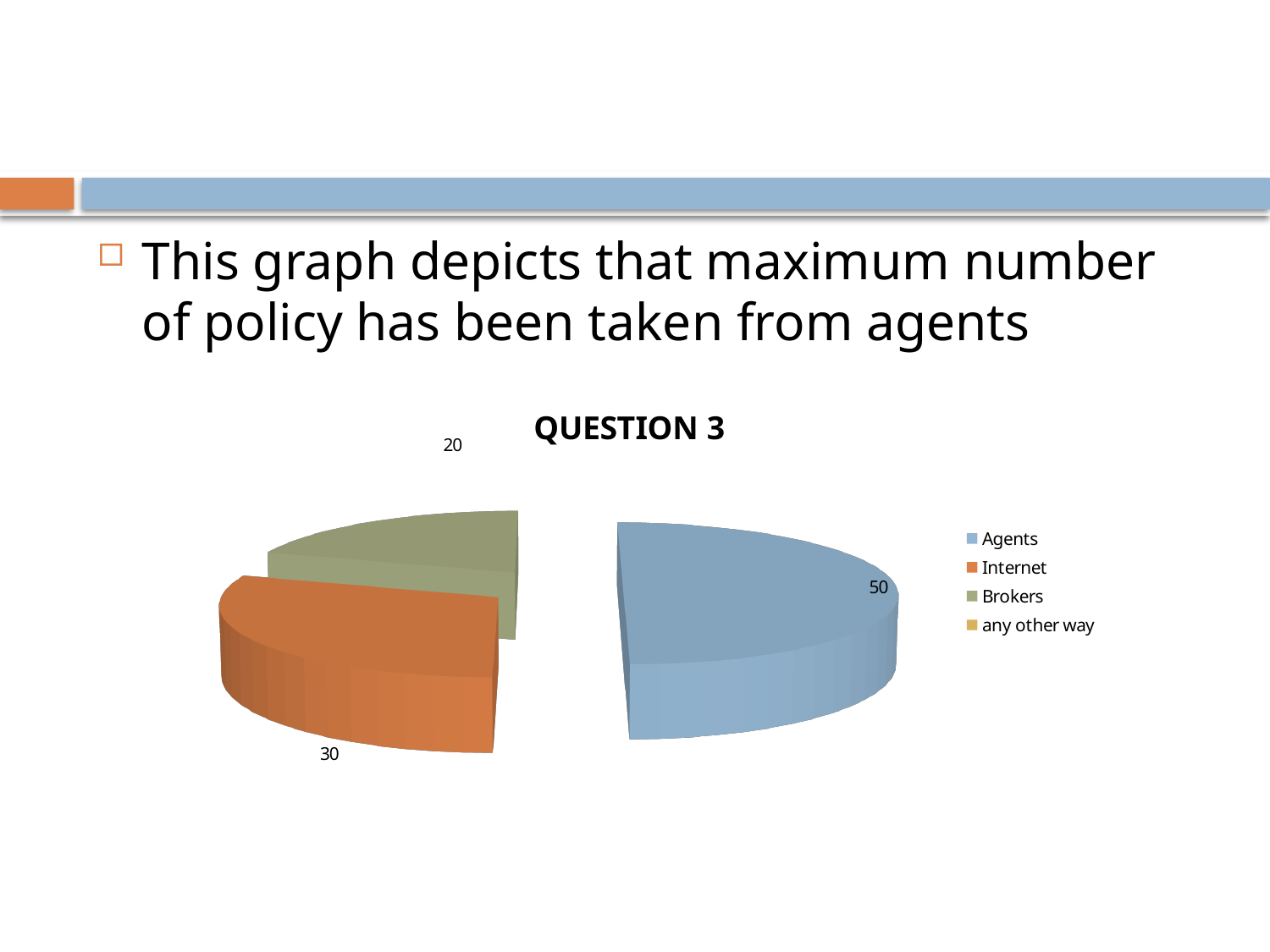
What is the title of the chart on the slide? QUESTION 3 How many entries does the legend of the QUESTION 3 chart list? 4 What colour is the Agents slice in the pie chart? Blue What is the difference between the values for Internet and Brokers? 10 What is the difference between the values for Agents and Internet? 20 Which is larger, the value for Internet or the value for Brokers? Internet What is the value for Agents in the QUESTION 3 pie chart? 50 What is the value for Brokers in the QUESTION 3 pie chart? 20 Which category has the largest slice in the QUESTION 3 pie chart? Agents What share of the labelled total (50 + 30 + 20) does the Agents slice represent? 50% What kind of chart is shown on the slide? Pie chart What is the value for Internet in the QUESTION 3 pie chart? 30